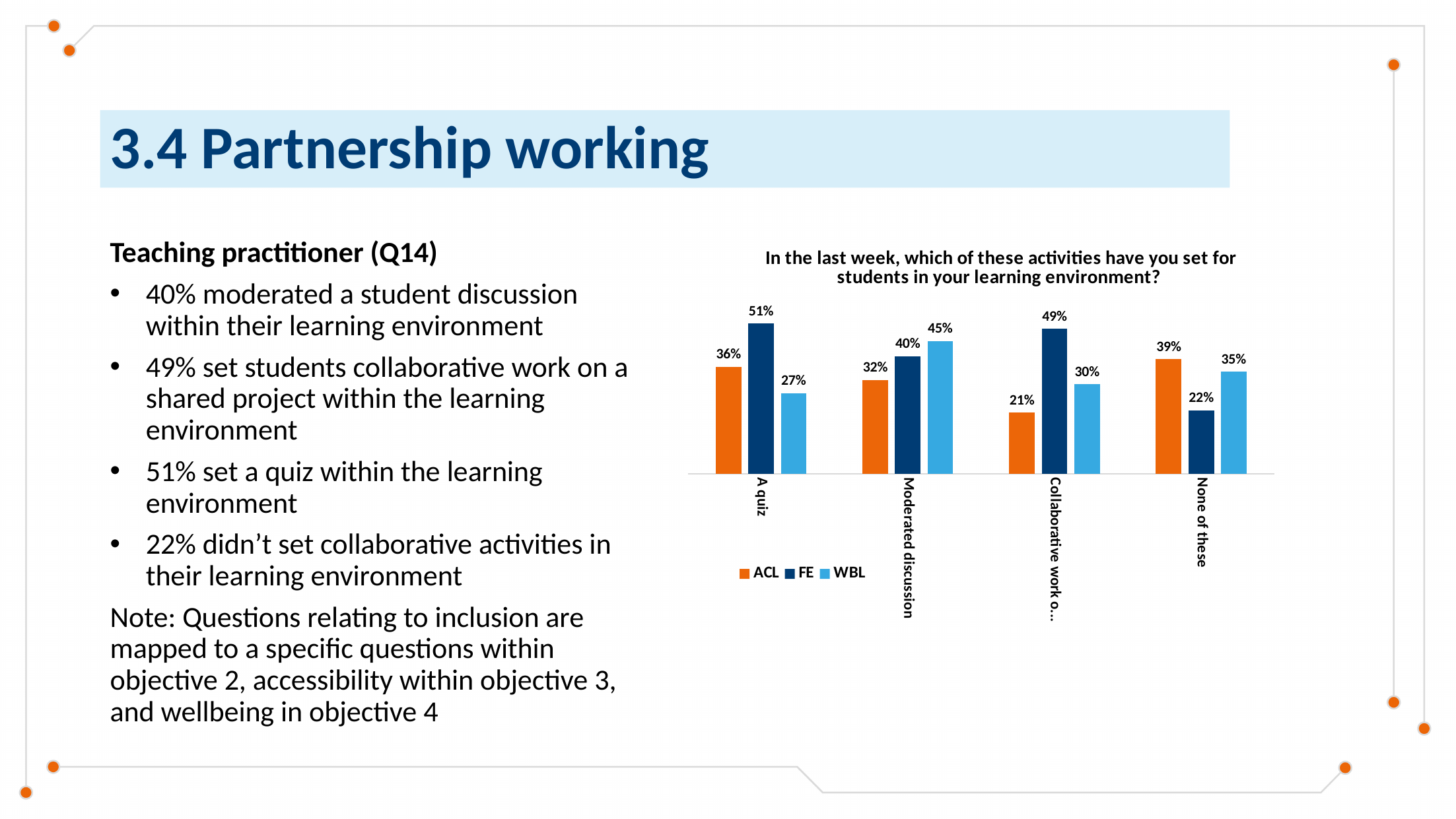
What is the FE value for 'A quiz'? 51% Which category has the highest FE value? A quiz What is the difference between the ACL and FE values for 'None of these'? 17% Which series is shown in orange in the legend? ACL How many series does the legend list? 3 How many categories are shown on the x axis? 4 What is the ACL value for 'None of these'? 39% Which category has the lowest ACL value? Collaborative work o... What kind of chart is shown on the slide? Bar chart What is the WBL value for 'Moderated discussion'? 45% For 'Moderated discussion', which series has the larger value, ACL or FE? FE What is the difference between the FE and WBL values for 'A quiz'? 24%